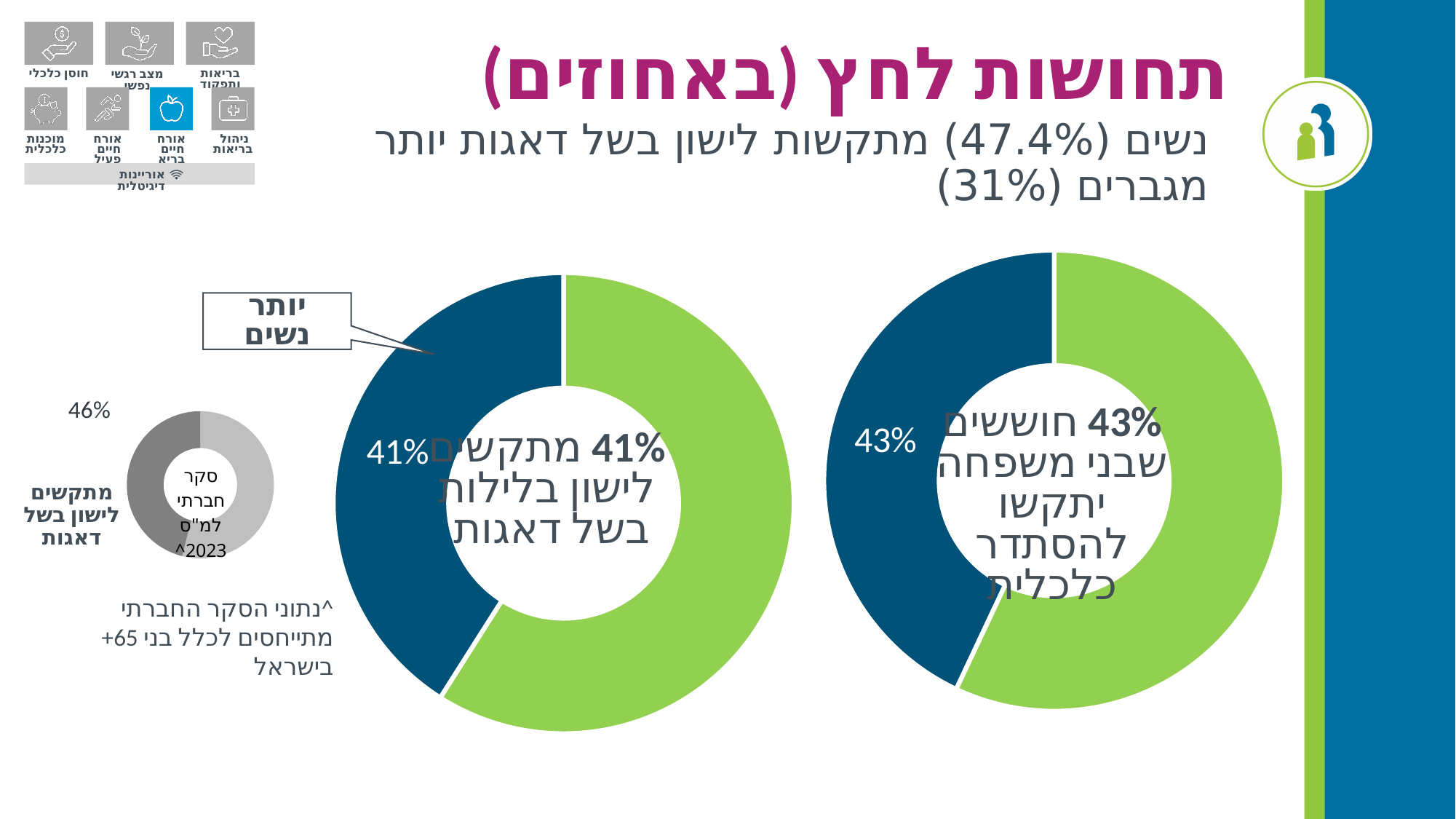
In the small grey donut chart on the left, what percentage is shown for those who have difficulty sleeping because of worries (מתקשים לישון בשל דאגות)? 46% Which is larger: the 41% value in the middle donut chart or the 43% value in the right donut chart? 43% (right chart) In the right donut chart, what percentage fear that family members will struggle financially (חוששים שבני משפחה יתקשו להסתדר כלכלית)? 43% How many donut charts are on the slide? 3 How many slices does the middle donut chart have? 2 In the middle donut chart, what percentage is shown for those who have difficulty sleeping at night because of worries (מתקשים לישון בלילות בשל דאגות)? 41% What kind of charts are shown on the slide? Donut (pie) charts According to the small grey donut chart's centre label, what is the data source? סקר חברתי למ"ס 2023 Which of the three donut charts shows the highest printed percentage? The small grey chart on the left (46%) What is the difference between the value in the right donut chart (43%) and the value in the middle donut chart (41%)? 2 percentage points What is the difference between the small grey donut chart value (46%) and the middle donut chart value (41%)? 5 percentage points In the middle donut chart, what colour is the slice labelled 41%? Dark blue